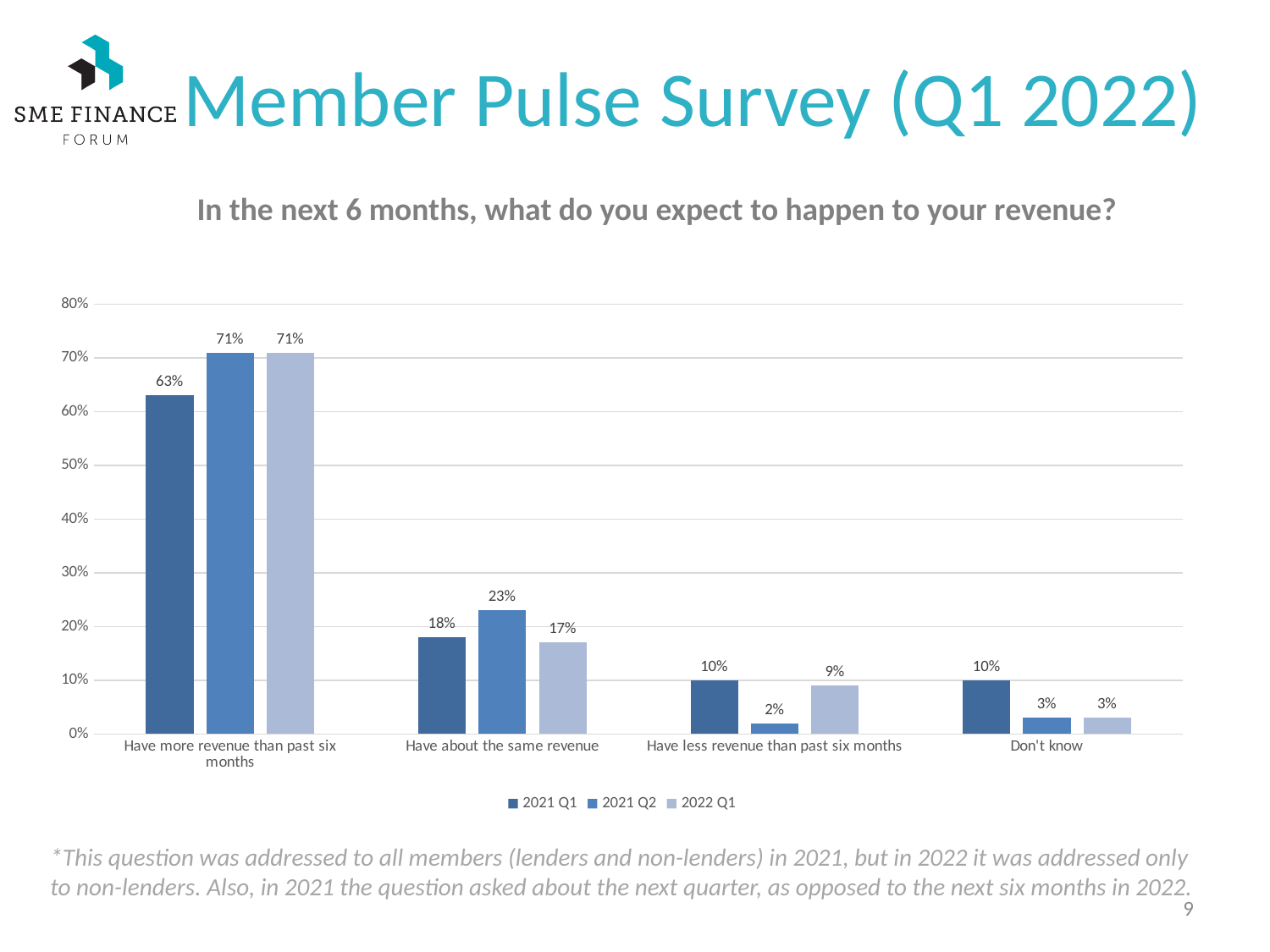
How many series does the legend list? 3 Which category has the highest value in the 2021 Q1 series? Have more revenue than past six months What is the value for 'Have more revenue than past six months' in the 2022 Q1 series? 71% How many categories are shown on the x axis? 4 What are the series names listed in the legend? 2021 Q1, 2021 Q2, 2022 Q1 Which category has the lowest value in the 2022 Q1 series? Don't know Which is larger for 'Have about the same revenue': the 2021 Q1 value or the 2022 Q1 value? 2021 Q1 What is the value for 'Don't know' in the 2021 Q1 series? 10% What is the difference between the 2021 Q2 and 2021 Q1 values for 'Have more revenue than past six months'? 8% What is the value for 'Have less revenue than past six months' in the 2021 Q2 series? 2% What kind of chart is shown on the slide? Bar chart What is the value for 'Have about the same revenue' in the 2021 Q2 series? 23%